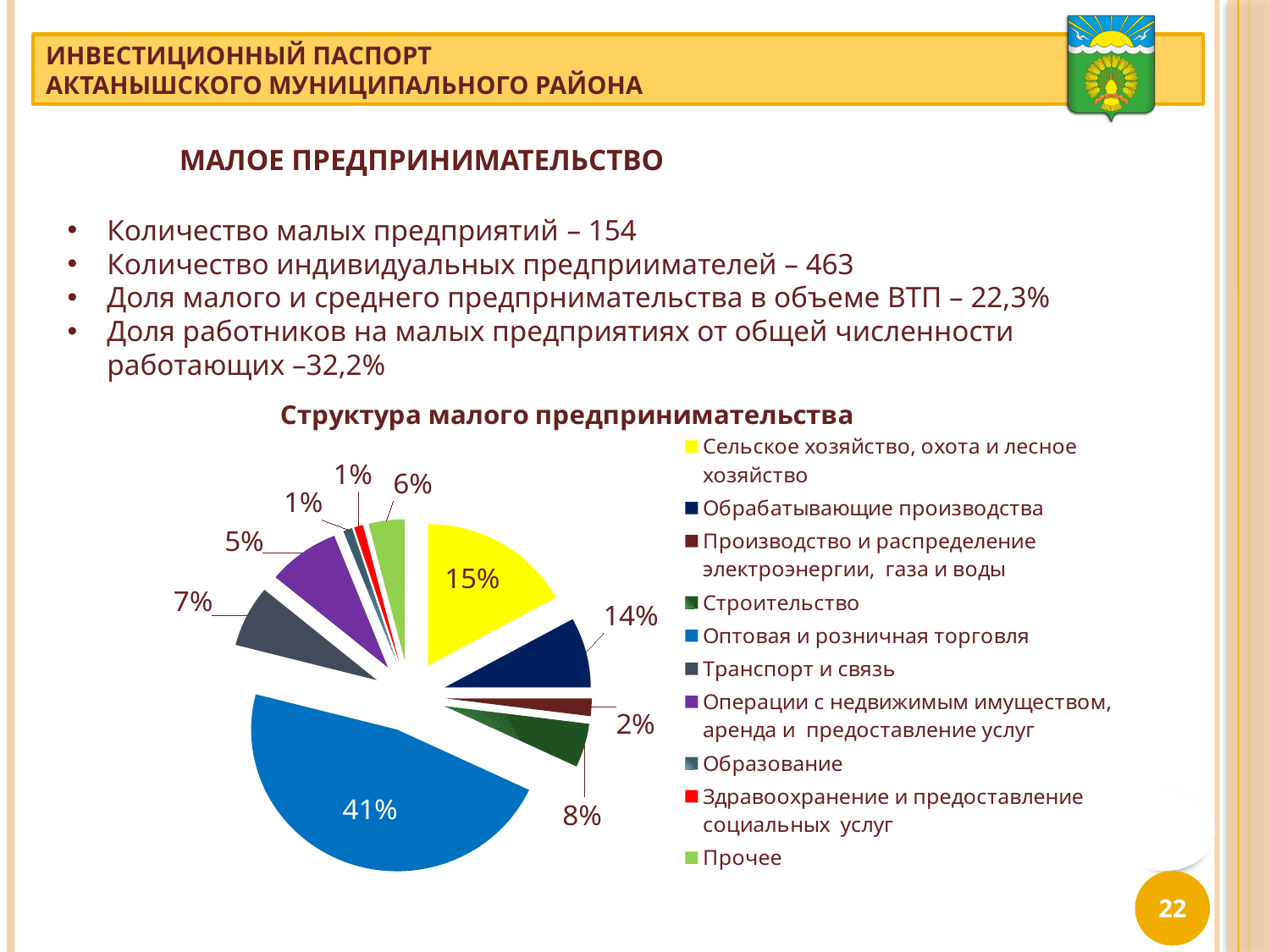
What share of the pie does "Обрабатывающие производства" have? 14% What share of the pie does "Прочее" have? 6% What share of the pie does "Строительство" have? 8% What share of the pie does "Транспорт и связь" have? 7% Which is larger: the share of "Строительство" or the share of "Транспорт и связь"? Строительство What share of the pie does "Сельское хозяйство, охота и лесное хозяйство" have? 15% How many categories does the legend of the pie chart list? 10 What share of the pie does "Оптовая и розничная торговля" have? 41% What kind of chart is shown under the title "Структура малого предпринимательства"? pie chart What is the difference between the shares of "Оптовая и розничная торговля" and "Сельское хозяйство, охота и лесное хозяйство"? 26% What is the title of the pie chart? Структура малого предпринимательства Which category has the largest slice of the pie? Оптовая и розничная торговля